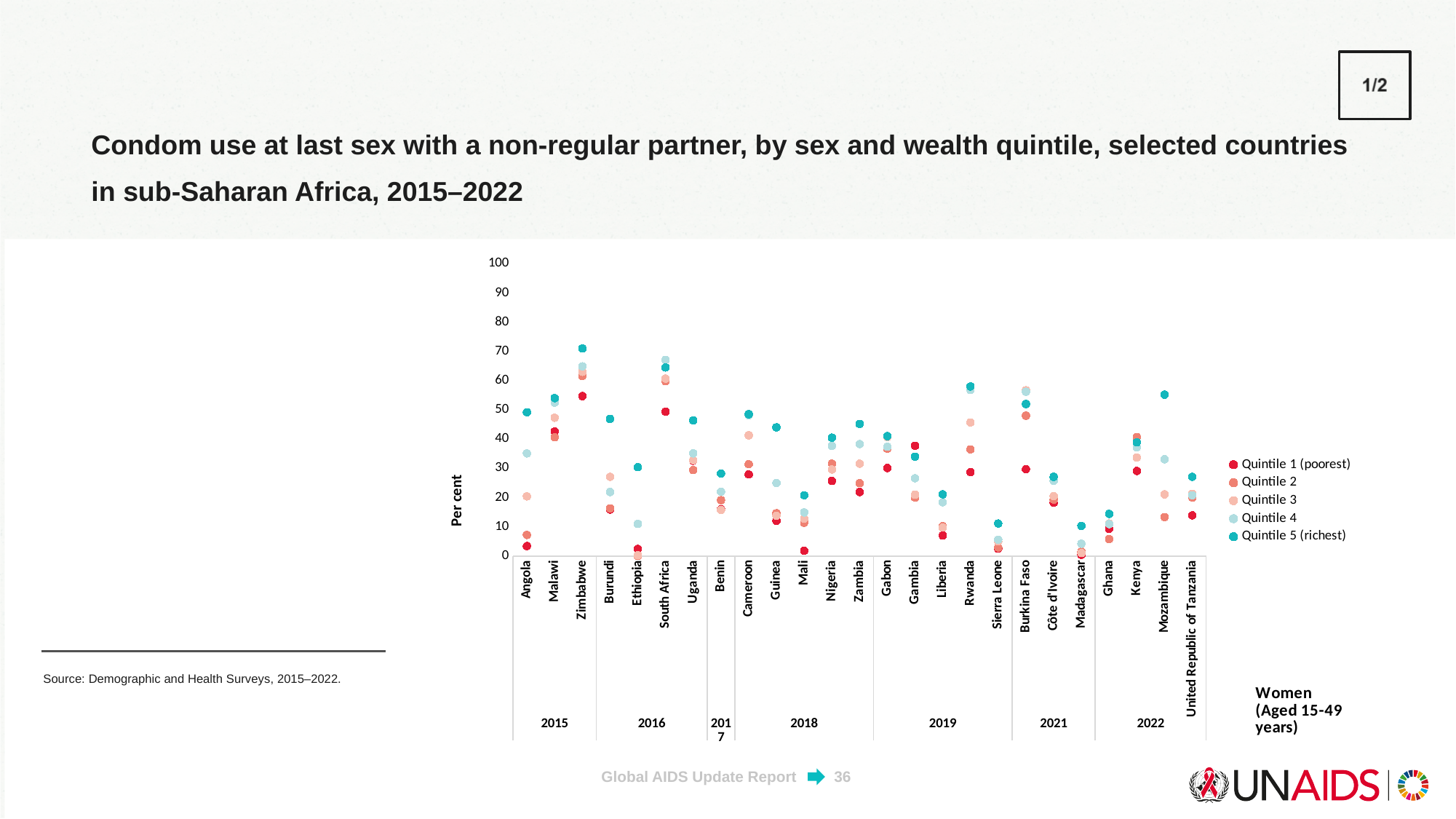
Which legend entry represents the richest wealth quintile? Quintile 5 (richest) Which is larger, the Quintile 1 (poorest) value for Zimbabwe or for Angola? Zimbabwe Is the Quintile 5 (richest) value for Rwanda greater or less than 50? greater Is the Quintile 1 (poorest) value for Angola greater or less than 10? less Is the Quintile 5 (richest) value for Mozambique greater or less than 50? greater What kind of chart is shown on the slide? Scatter (dot) chart How many series does the legend list? 5 Which country has the highest value for Quintile 5 (richest)? Zimbabwe How many countries are shown along the x axis? 25 What is the label on the vertical axis? Per cent